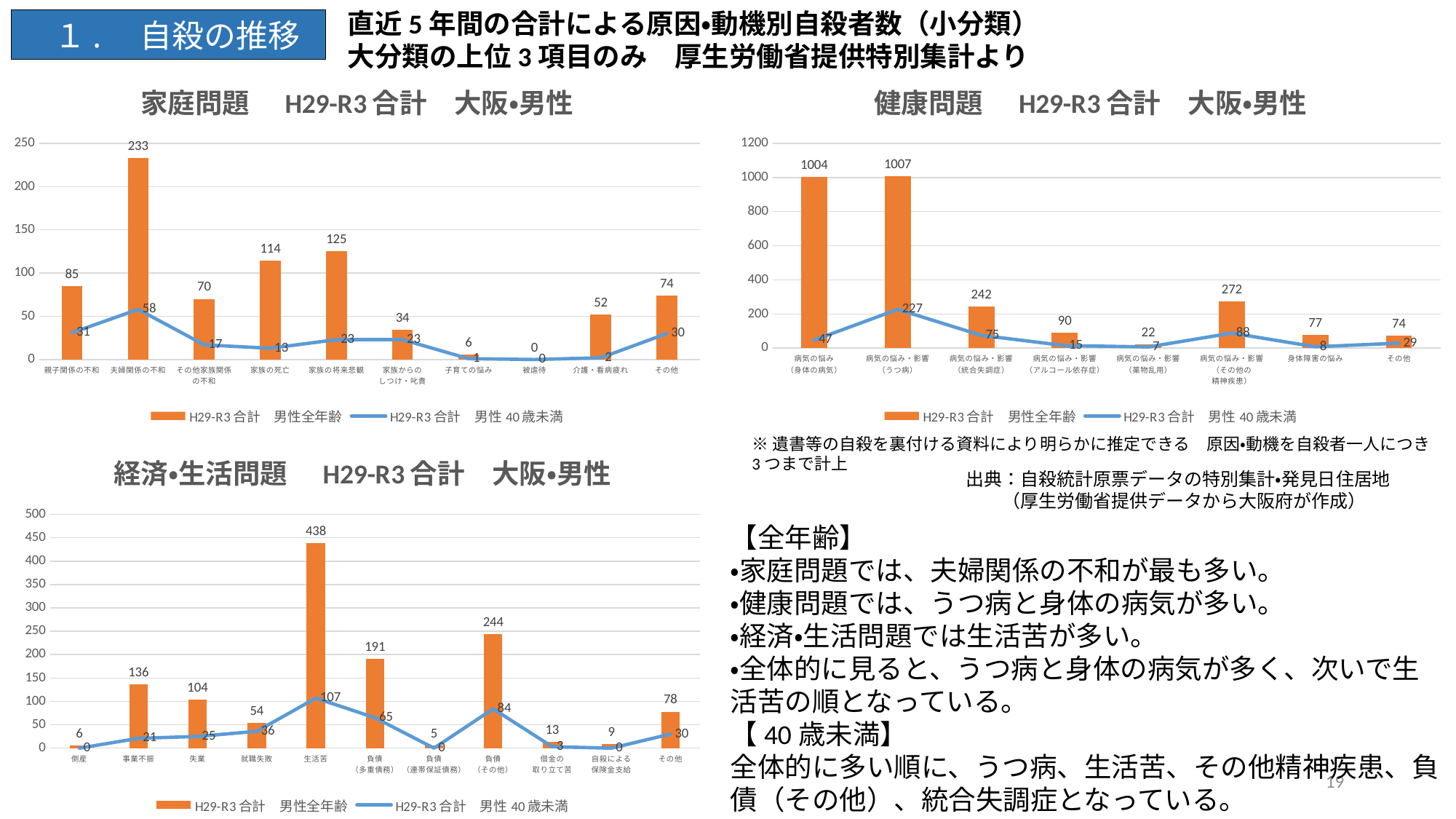
In the 家庭問題 chart (top left), how many categories are shown on the x axis? 10 In the 家庭問題 chart (top left), which category has the highest 男性全年齢 bar? 夫婦関係の不和 In the 健康問題 chart (top right), is the 男性全年齢 value for 病気の悩み・影響（統合失調症）greater or less than 200? greater In the 経済・生活問題 chart (bottom left), what is the difference between the 男性全年齢 and 男性40歳未満 values for 生活苦? 331 In the 経済・生活問題 chart (bottom left), which is larger for 男性全年齢: 負債（多重債務）or 負債（その他）? 負債（その他） In the 健康問題 chart (top right), how many series does the legend list? 2 In the 健康問題 chart (top right), which category has the lowest 男性全年齢 bar? 病気の悩み・影響（薬物乱用） In the 家庭問題 chart (top left), what is the difference between the 男性全年齢 values for 家族の将来悲観 and 家族の死亡? 11 What kind of chart is the 経済・生活問題 chart (bottom left)? Combined bar and line chart In the 健康問題 chart (top right), what is the 男性40歳未満 line value for 病気の悩み・影響（うつ病）? 227 In the 経済・生活問題 chart (bottom left), what is the 男性全年齢 value for 生活苦? 438 In the 家庭問題 chart (top left), what is the value of the H29-R3合計 男性全年齢 bar for 夫婦関係の不和? 233